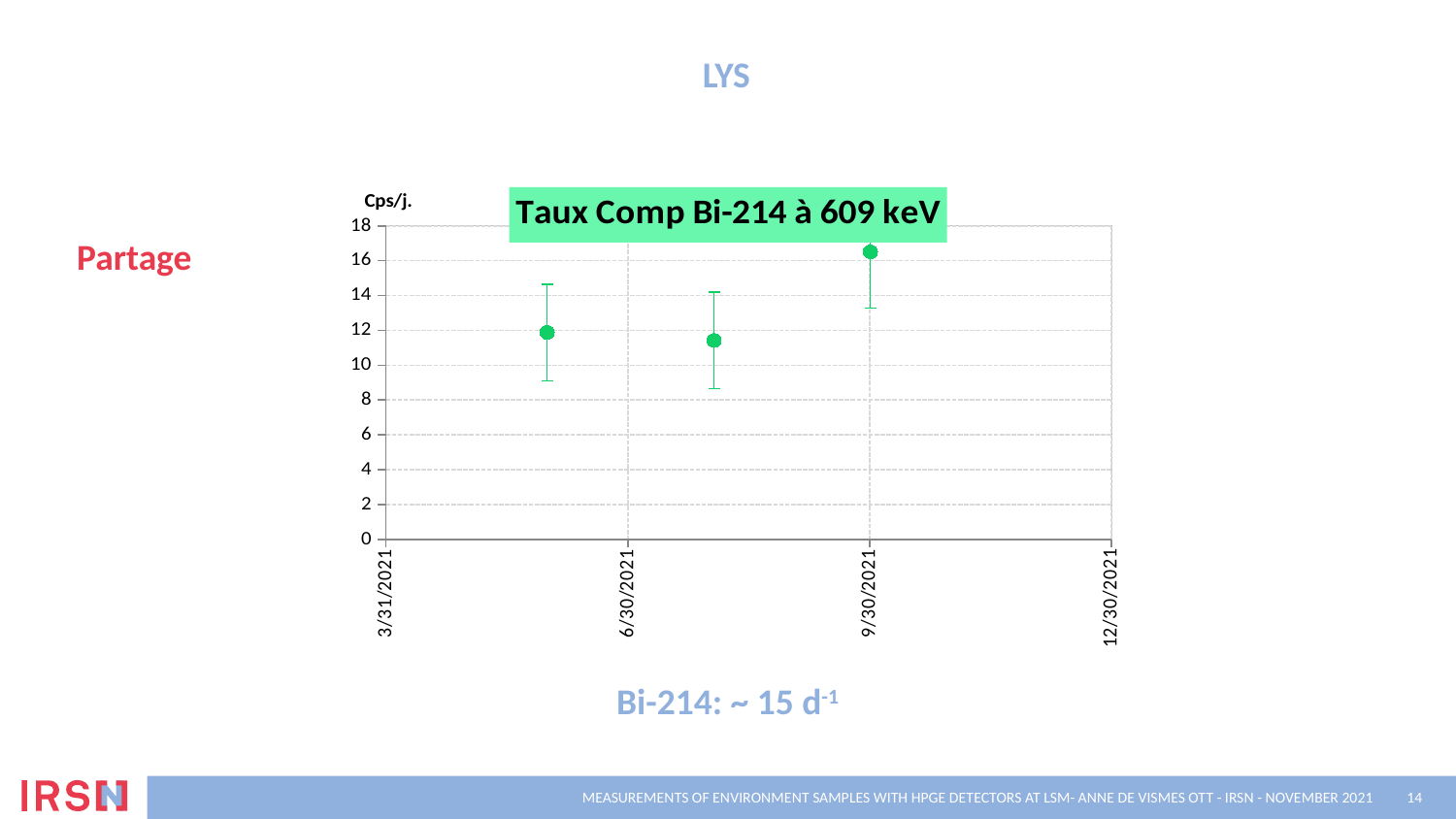
What is the last date label on the x axis? 12/30/2021 Which data point has the highest value: the first, second or third? the third What unit is shown on the y axis of the chart? Cps/j. What kind of chart is shown on the slide? scatter chart with error bars Is the value of the first (leftmost) data point greater or less than 14? less Is the third data point higher or lower than the first data point? higher Is the value of the second data point greater or less than 10? greater Is the value of the data point plotted at 9/30/2021 greater or less than 14? greater How many date labels are shown on the x axis? 4 How many data points are plotted on the chart? 3 What is the title of the chart? Taux Comp Bi-214 à 609 keV What is the maximum value shown on the y axis? 18